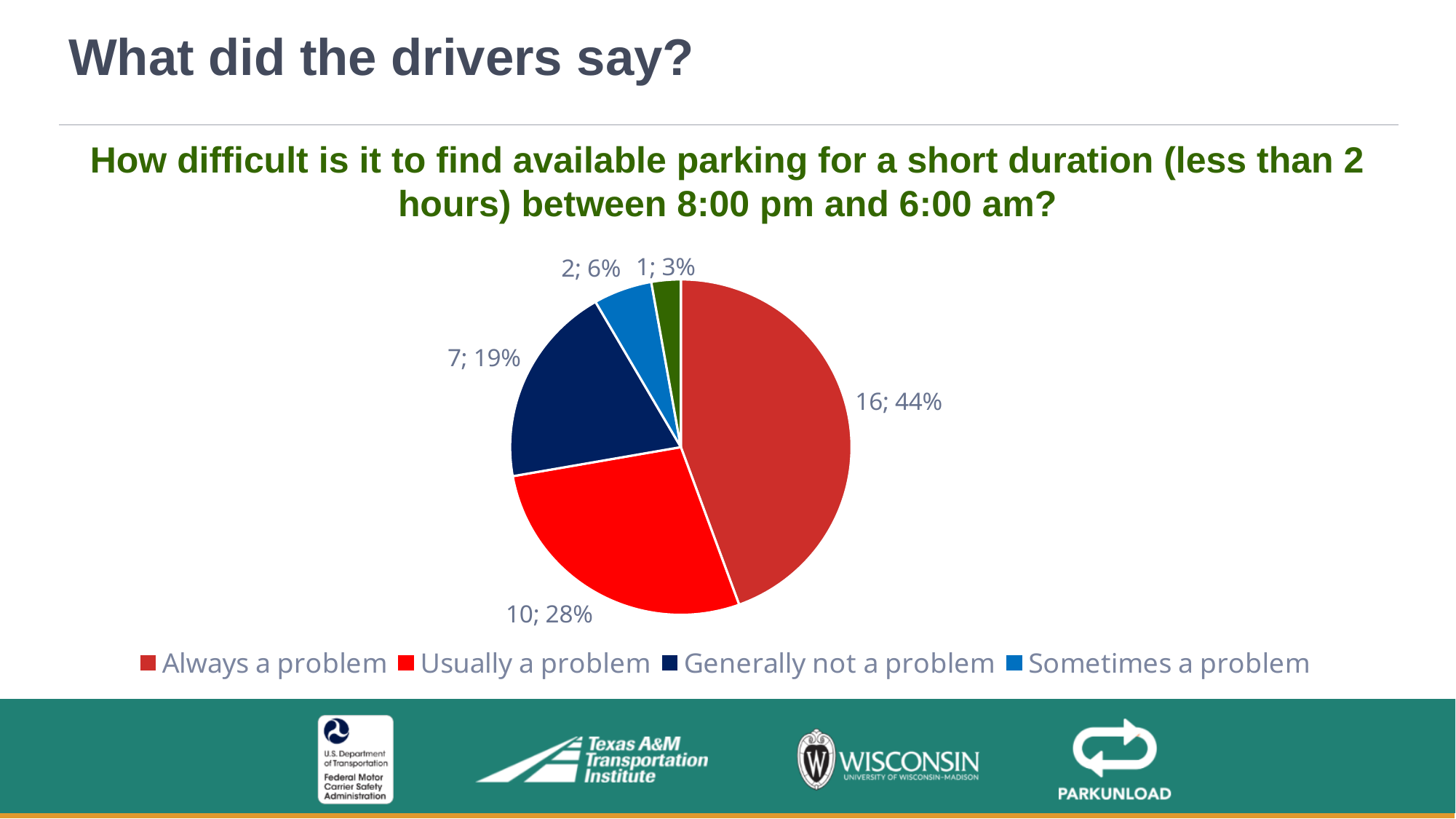
What percentage of the pie is "Usually a problem"? 28% Which is larger: the count for "Generally not a problem" or for "Sometimes a problem"? Generally not a problem How many respondents said parking is "Generally not a problem"? 7 What percentage of the pie is "Sometimes a problem"? 6% What is the total number of respondents across all slices of the pie? 36 Which response category has the largest slice of the pie? Always a problem How many slices does the pie chart have? 5 What is the percentage shown on the smallest slice of the pie? 3% How many more respondents chose "Always a problem" than "Usually a problem"? 6 How many entries does the legend list? 4 What kind of chart is shown on the slide? pie chart How many respondents said parking is "Always a problem"? 16